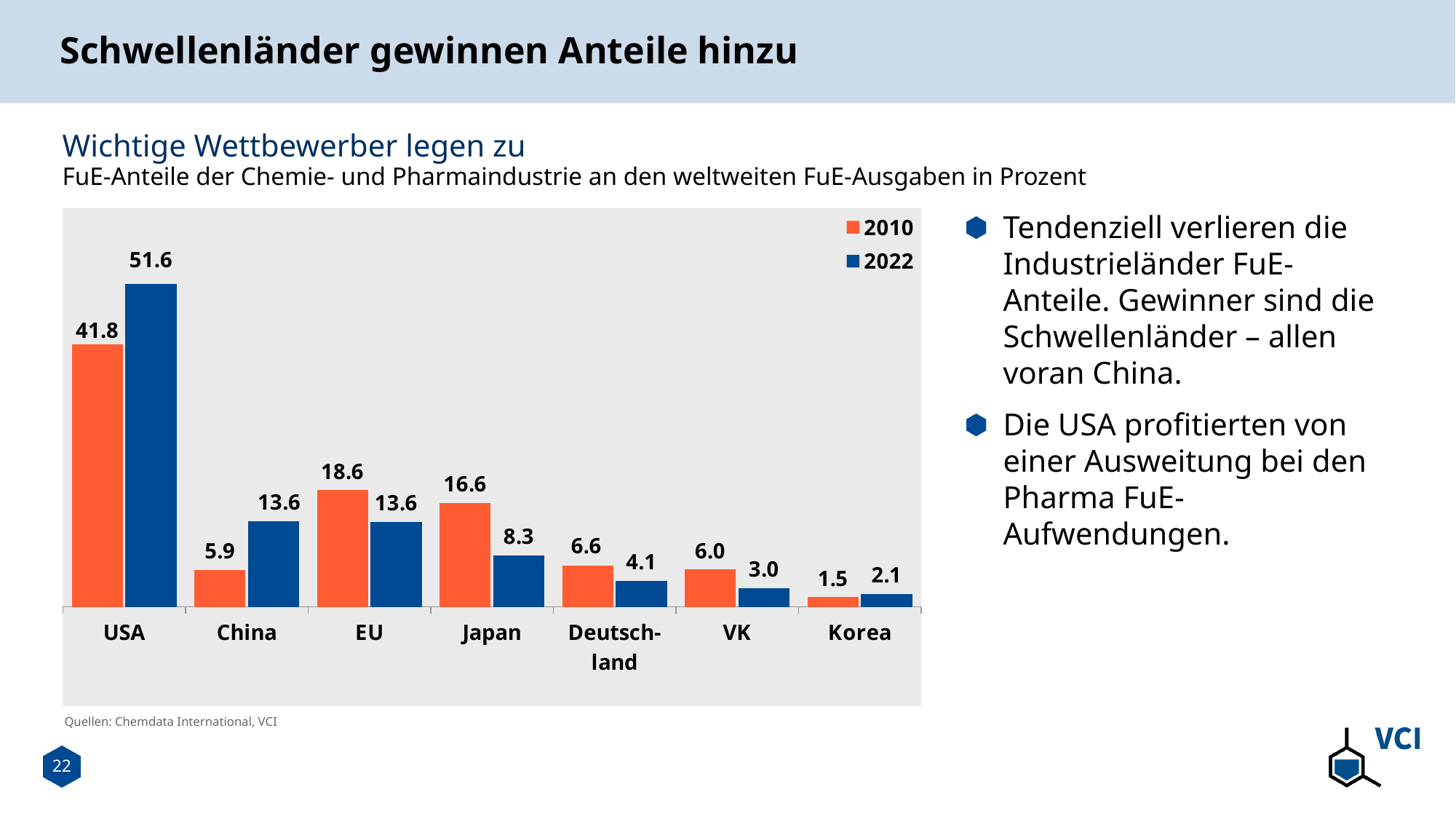
Which is larger: the 2010 value for EU or the 2010 value for Japan? EU What is the difference between the 2010 and 2022 values for Japan? 8.3 What is the value for USA in 2022? 51.6 What is the difference between the 2022 and 2010 values for China? 7.7 What is the value for Deutschland in 2022? 4.1 What is the value for China in 2010? 5.9 Which category has the lowest value in 2010? Korea Which category has the highest value in 2022? USA How many categories are shown on the x axis? 7 How many series does the legend list? 2 Which colour represents the 2010 series in the legend? orange What kind of chart is shown on the slide? bar chart